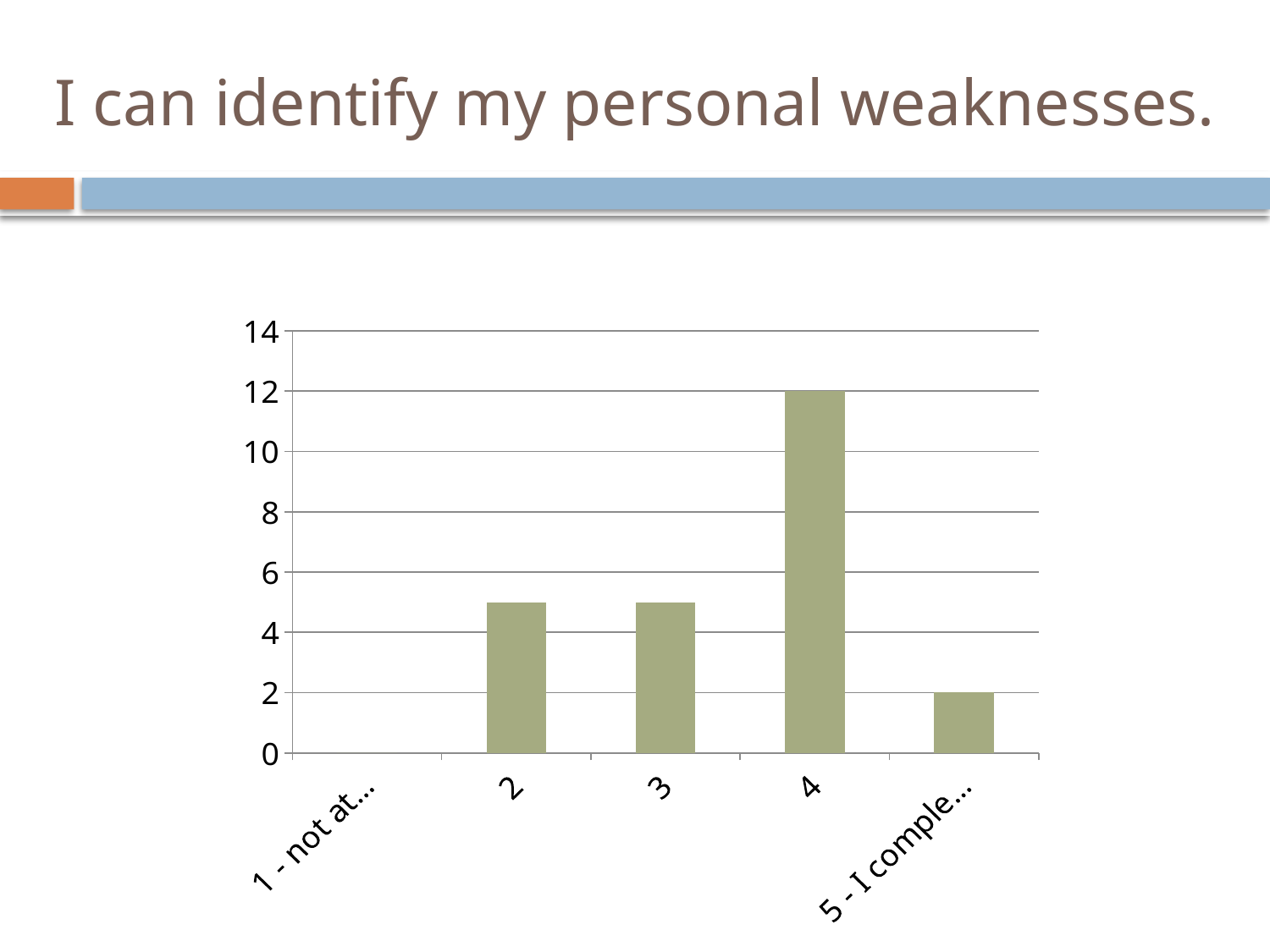
Which is larger, the value for category 4 or the value for the category labelled "5 - I comple..."? 4 What kind of chart is shown on the slide? bar chart How many categories are shown on the x axis of the chart? 5 What is the value for the category labelled "5 - I comple..."? 2 What is the difference between the value for category 4 and the value for the category labelled "5 - I comple..."? 10 What is the title of the slide above the chart? I can identify my personal weaknesses. What is the highest value shown on the vertical axis? 14 What is the value for category 4? 12 Is the value for category 4 greater or less than 10? greater Is the value for category 2 greater or less than 4? greater Is the value for category 3 greater or less than 6? less Which category has the highest bar? 4